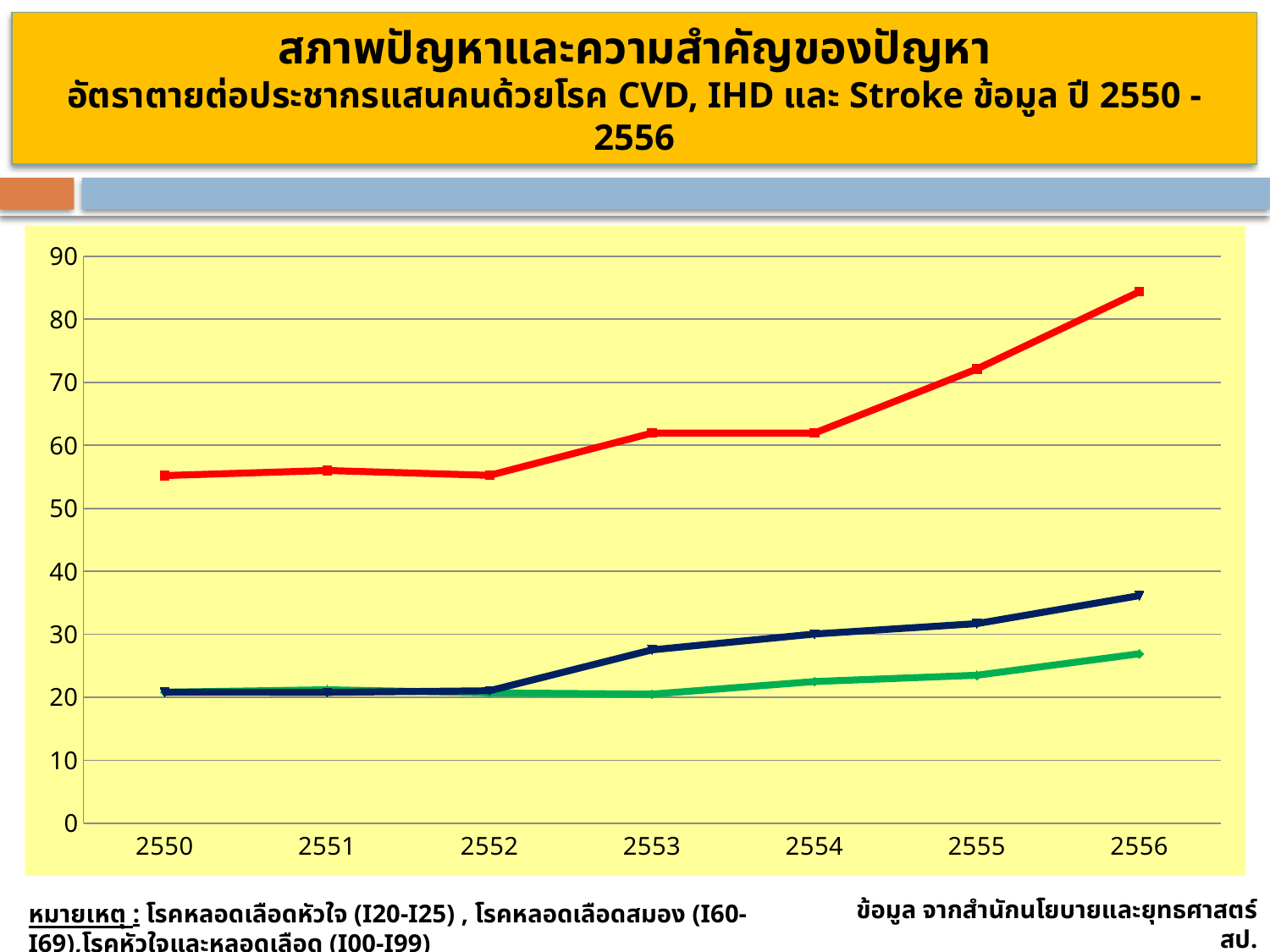
What kind of chart is shown on the slide? line chart What is the highest value shown on the y axis? 90 Is the value of the red line in 2550 greater or less than 50? greater How many lines are plotted on the chart? 3 Does the red line generally rise or fall from 2550 to 2556? rise What is the first year shown on the x axis? 2550 Is the value of the red line in 2556 greater or less than 80? greater How many years are shown on the x axis of the chart? 7 Is the value of the green line in 2556 greater or less than 30? less In which year does the red line reach its highest value? 2556 In 2556, which line has the larger value, the dark blue line or the green line? dark blue line